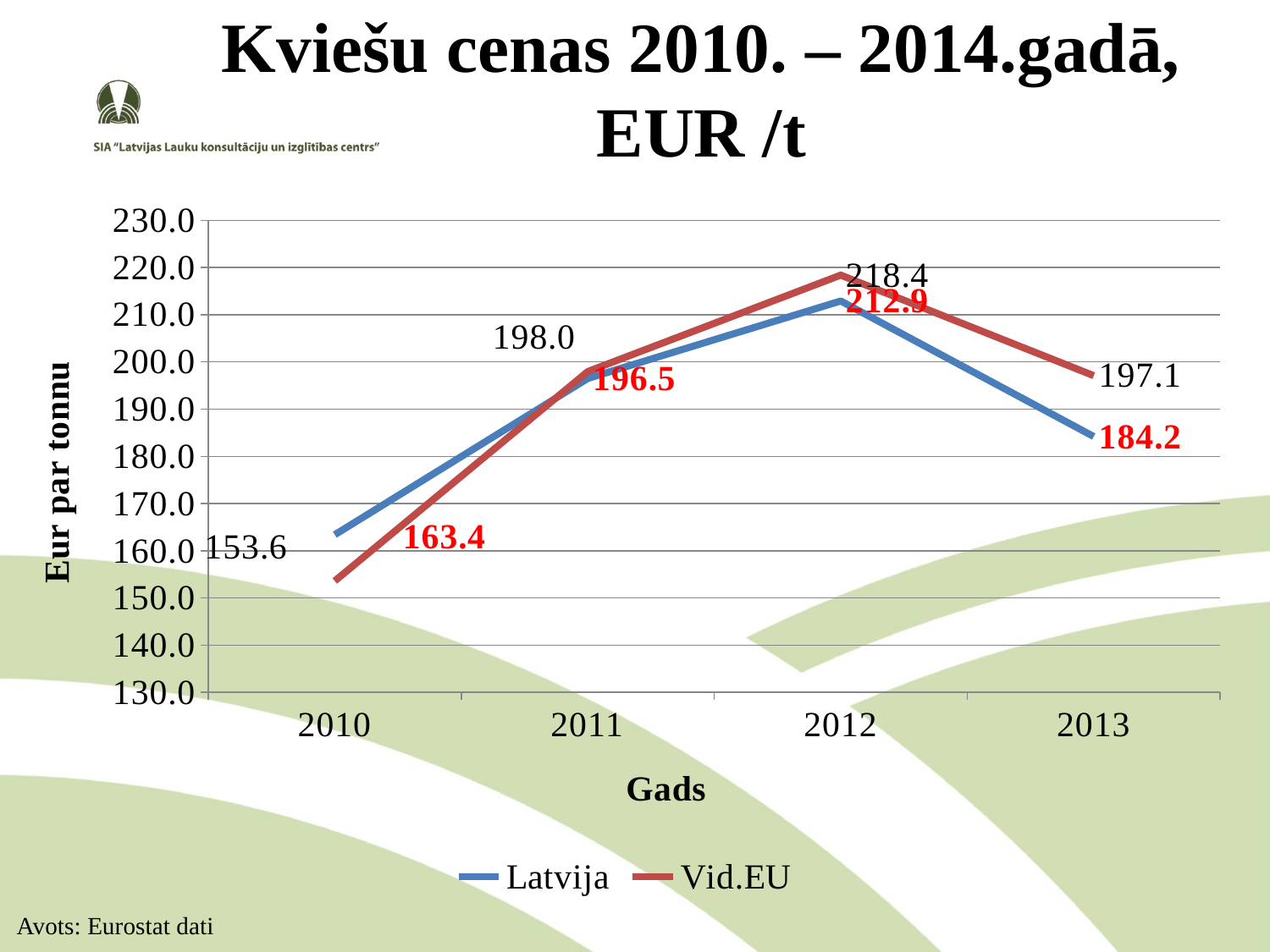
What is the difference between the Vid.EU and Latvija values in 2013? 12.9 What is the label of the y axis? Eur par tonnu What is the value for Latvija in 2010? 163.4 What kind of chart is shown on the slide? Line chart What is the value for Latvija in 2012? 212.9 In which year is the Latvija value lowest? 2010 What is the value for Vid.EU in 2011? 198.0 How many years are shown on the x axis? 4 How many series does the legend list? 2 Which is larger in 2010, the Latvija value or the Vid.EU value? Latvija In which year is the Vid.EU value highest? 2012 What is the value for Vid.EU in 2013? 197.1